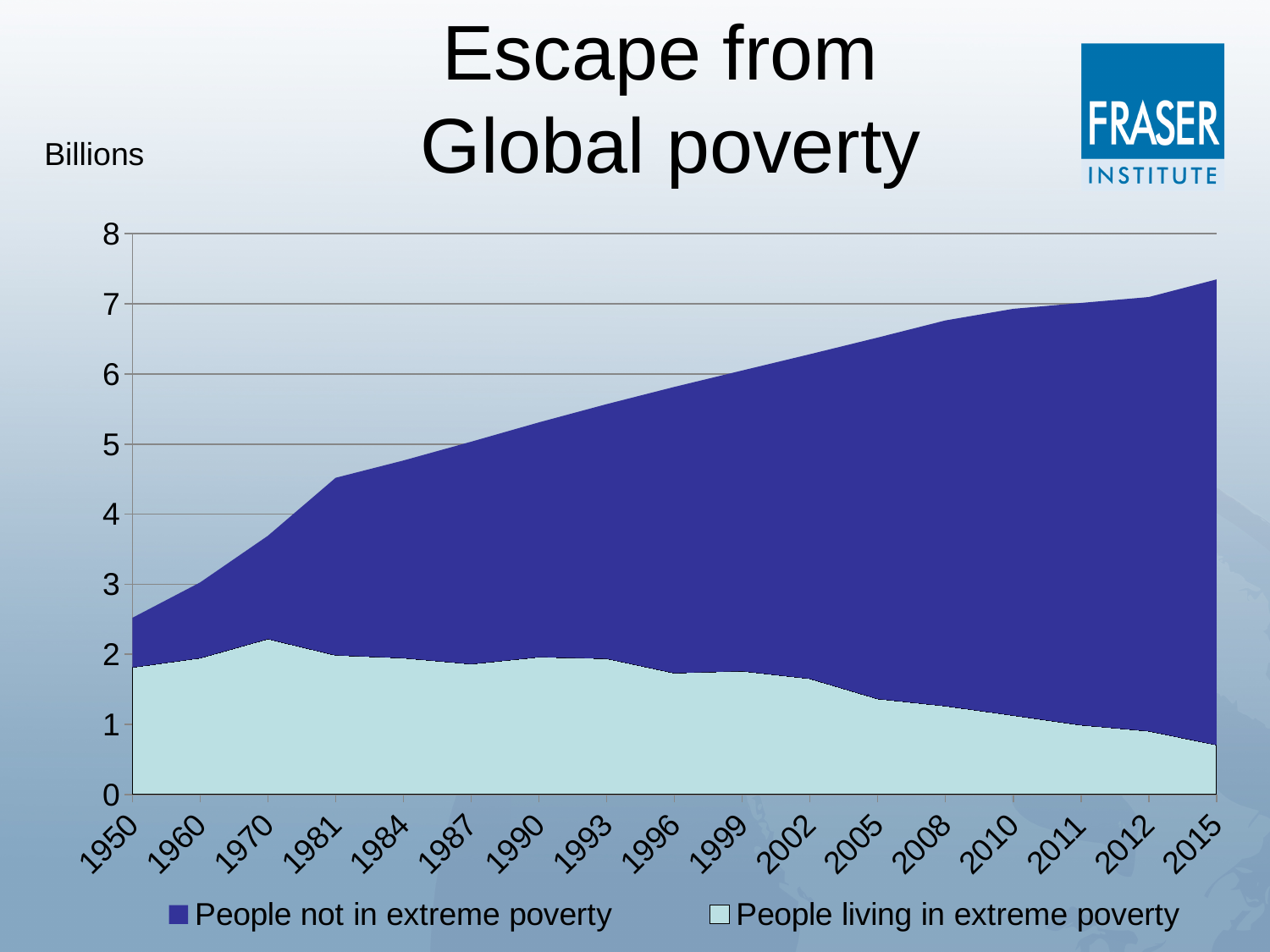
In which year is the value for People living in extreme poverty lowest? 2015 Is the value for People living in extreme poverty in 1970 greater or less than 2? greater What kind of chart is shown on the slide? Stacked area chart How many years are labelled along the x axis? 17 What unit is the vertical axis measured in? Billions Does the total population shown (top of the stacked area) rise or fall from 1950 to 2015? Rise Is the total height of the stacked area in 2015 greater or less than 7? greater Does the number of People living in extreme poverty rise or fall from 1970 to 2015? Fall Is the total height of the stacked area in 1950 greater or less than 3? less What is the title of the chart? Escape from Global poverty How many series does the legend list? 2